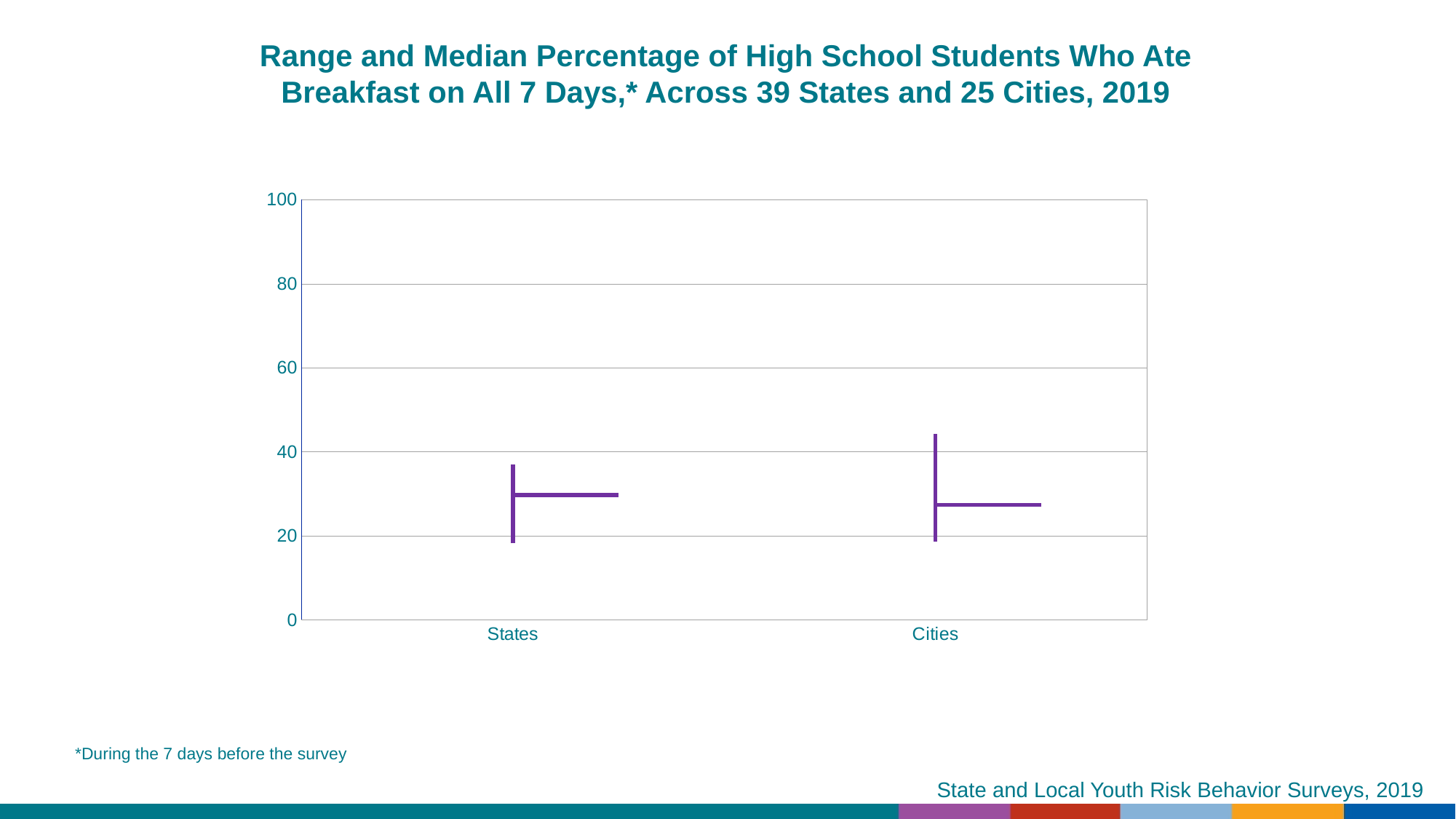
What does the asterisk in the chart title refer to, according to the footnote? During the 7 days before the survey How many categories are shown on the x axis of the chart? 2 Which category has the higher maximum value in its range, States or Cities? Cities Which category shows the wider range of values? Cities Is the top of the range for States greater or less than 40? less Is the median value for States greater or less than 40? less What is the highest value shown on the y axis? 100 Is the median value for Cities greater or less than 40? less What kind of chart is shown on the slide? A range (high-low) chart with median markers